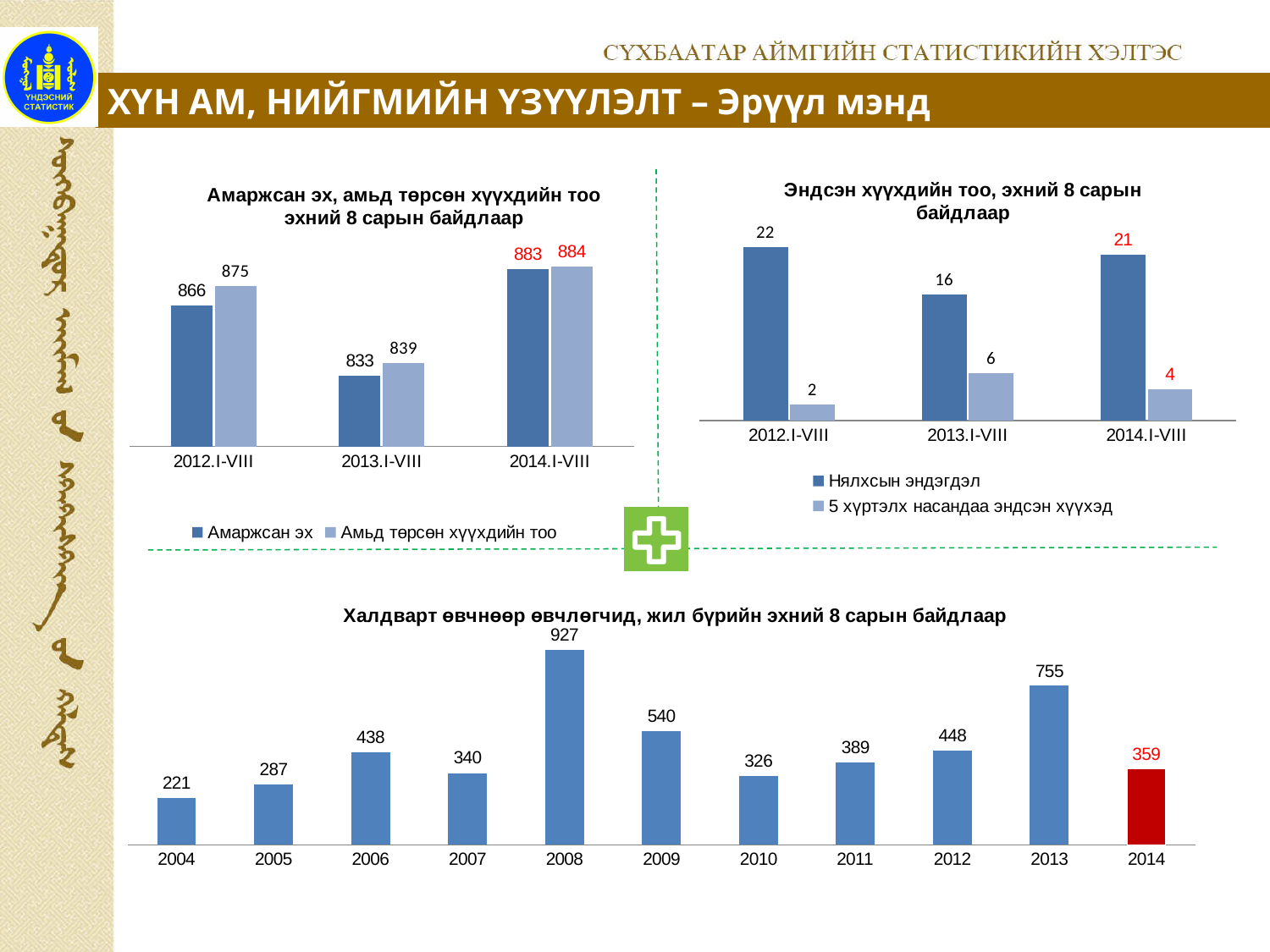
In the top-left chart (Амаржсан эх, амьд төрсөн хүүхдийн тоо), how many series does the legend list? 2 In the bottom chart (Халдварт өвчнөөр өвчлөгчид), which year has the lowest value? 2004 In the top-right chart (Эндсэн хүүхдийн тоо), what is the value of Нялхсын эндэгдэл for 2013.I-VIII? 16 In the top-left chart (Амаржсан эх, амьд төрсөн хүүхдийн тоо), what is the value of Амьд төрсөн хүүхдийн тоо for 2013.I-VIII? 839 In the top-right chart (Эндсэн хүүхдийн тоо), in which period is the value of 5 хүртэлх насандаа эндсэн хүүхэд highest? 2013.I-VIII In the bottom chart (Халдварт өвчнөөр өвчлөгчид), how many years are shown on the x axis? 11 In the bottom chart (Халдварт өвчнөөр өвчлөгчид), what is the difference between the values for 2013 and 2014? 396 In the bottom chart (Халдварт өвчнөөр өвчлөгчид), which year has the highest value? 2008 In the bottom chart (Халдварт өвчнөөр өвчлөгчид), what is the value for 2008? 927 What kind of chart is the bottom chart (Халдварт өвчнөөр өвчлөгчид)? Bar chart In the bottom chart (Халдварт өвчнөөр өвчлөгчид), which is larger, the value for 2010 or the value for 2011? 2011 In the top-left chart (Амаржсан эх, амьд төрсөн хүүхдийн тоо), what is the difference between Амьд төрсөн хүүхдийн тоо and Амаржсан эх for 2012.I-VIII? 9